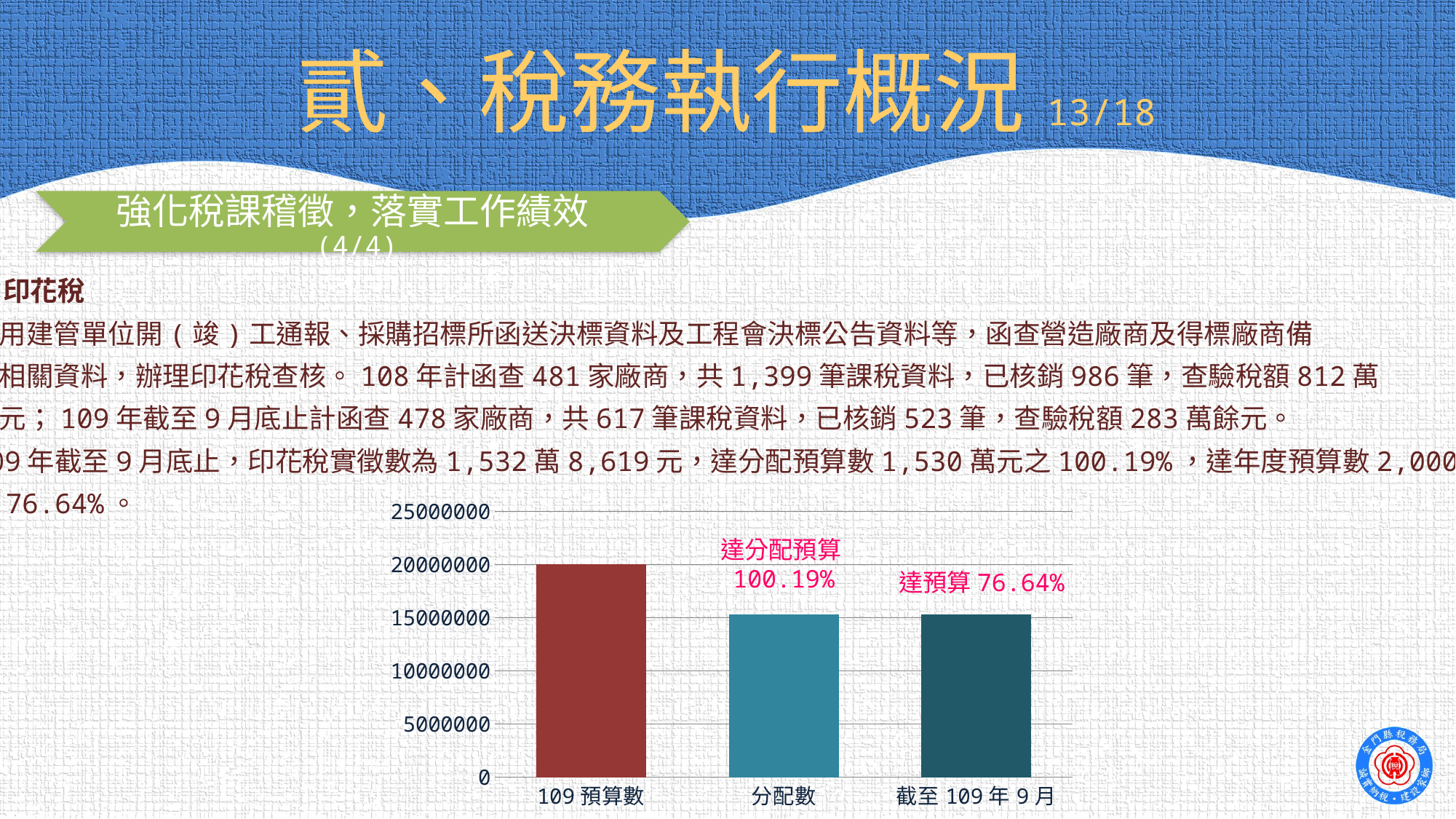
What percentage is shown in the annotation labelled 達分配預算 above the chart? 100.19% How many bars (categories) does the chart show? 3 Is the value for 截至109年9月 greater or less than 10000000? greater Which category has the highest bar in the chart? 109預算數 What kind of chart is shown on the slide? bar chart What is the highest value shown on the chart's vertical axis? 25000000 What percentage is shown in the annotation labelled 達預算 above the chart? 76.64% Is the value for 分配數 greater or less than 20000000? less Which is larger, the bar for 109預算數 or the bar for 分配數? 109預算數 Is the value for 109預算數 greater or less than 15000000? greater